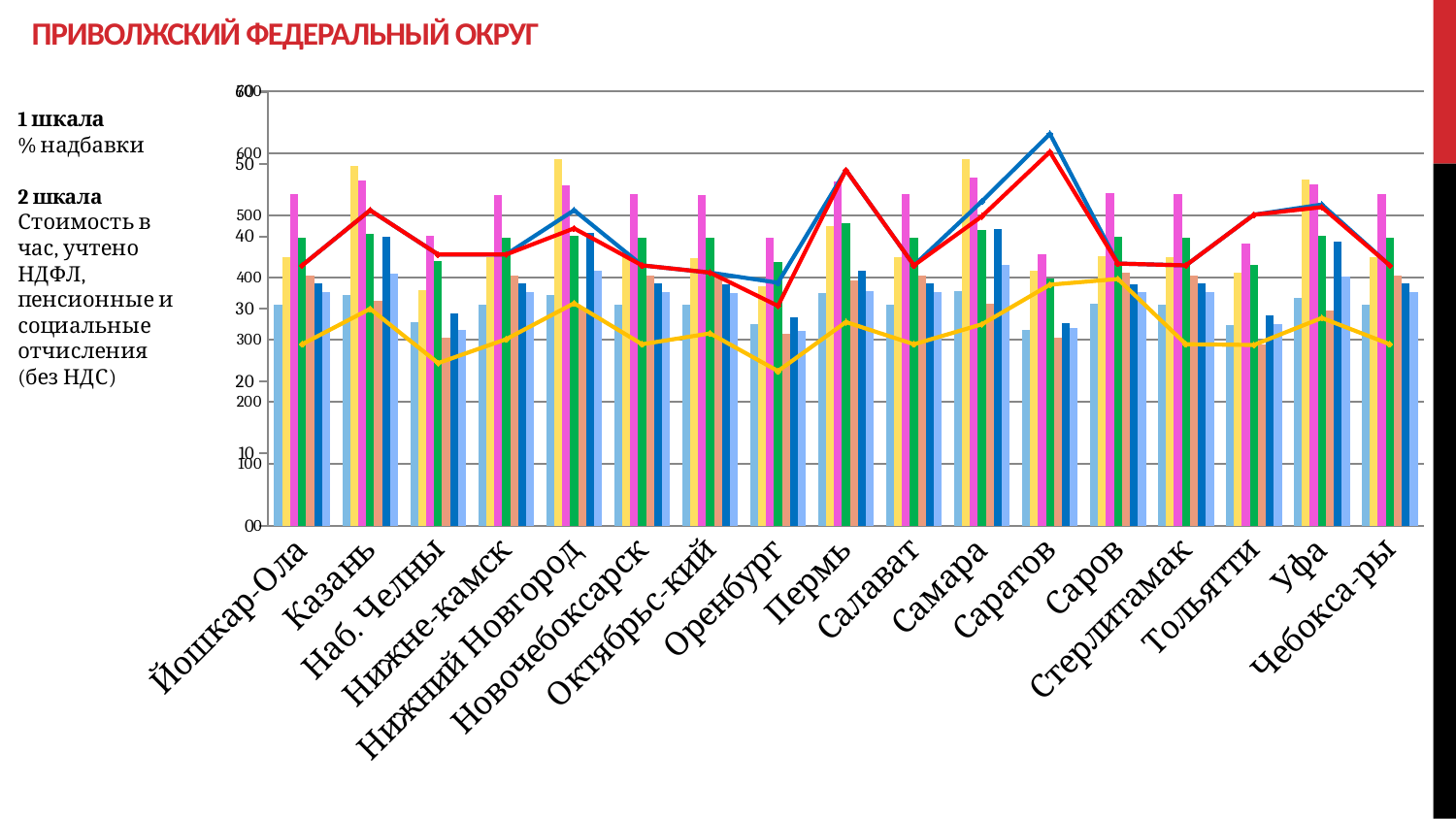
How many lines are plotted on the chart? 3 Is the yellow line higher at Саров or at Оренбург? Саров Is the red line higher at Пермь or at Оренбург? Пермь How many cities are shown along the x axis of the chart? 17 Is the blue line higher at Саратов or at Оренбург? Саратов What is the title of the slide containing the chart? ПРИВОЛЖСКИЙ ФЕДЕРАЛЬНЫЙ ОКРУГ For which city does the yellow line reach its lowest point? Оренбург How many bars are shown for each city on the chart? 7 What is the first city listed on the x axis of the chart? Йошкар-Ола For which city does the red line reach its highest point? Саратов What kind of chart is shown on the slide? Combined bar and line chart For which city does the blue line reach its highest point? Саратов